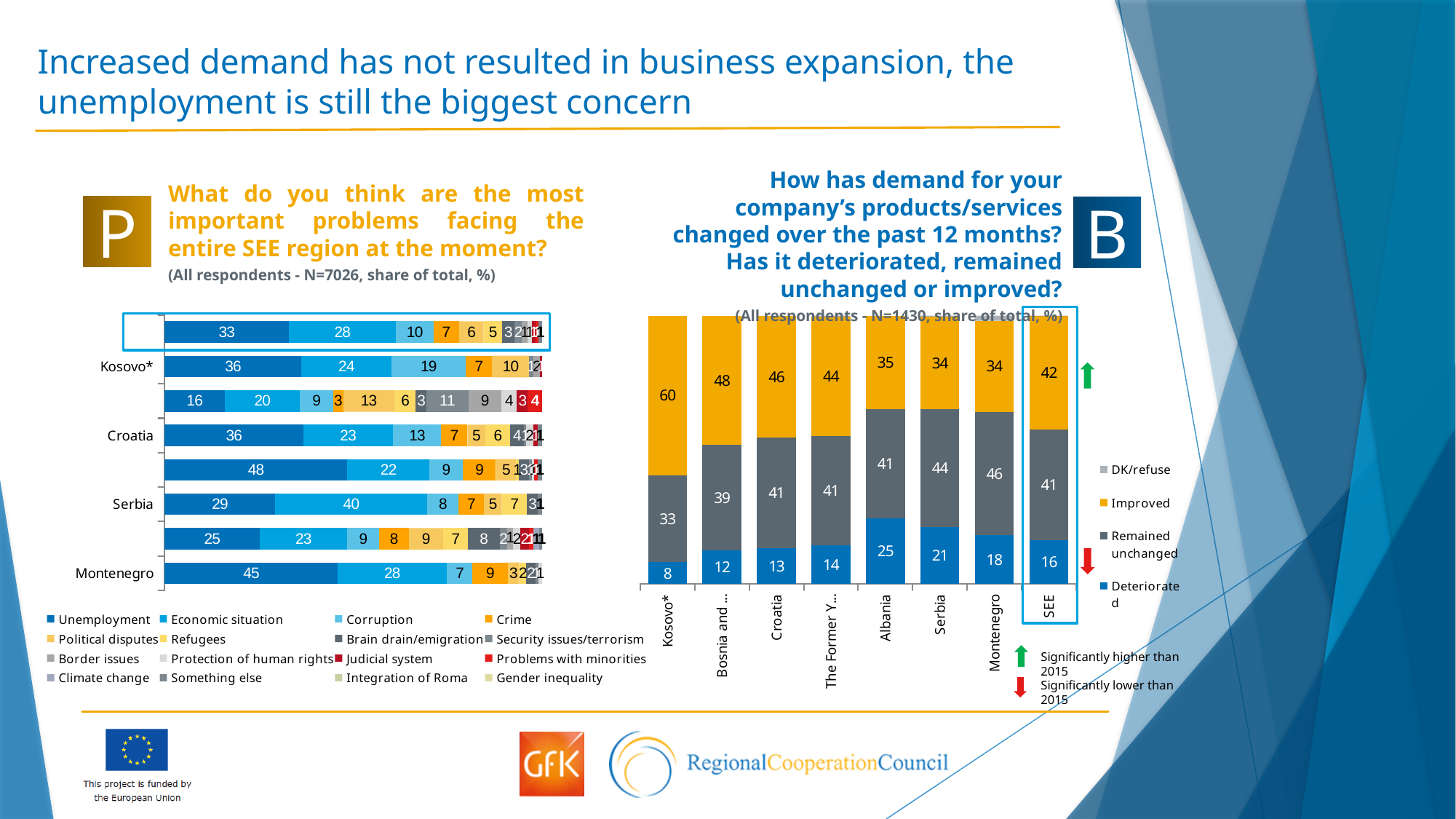
How many series does the legend of the chart 'How has demand for your company's products/services changed over the past 12 months?' list? 4 What kind of chart is the chart 'How has demand for your company's products/services changed over the past 12 months?'? Stacked bar chart In the chart 'How has demand for your company's products/services changed over the past 12 months?', what is the value for Deteriorated for Albania? 25 In the chart 'How has demand for your company's products/services changed over the past 12 months?', what is the total of the stacked bar for Croatia? 100 In the chart 'What do you think are the most important problems facing the entire SEE region at the moment?', what is the Economic situation value for Serbia? 40 In the chart 'How has demand for your company's products/services changed over the past 12 months?', which country has the highest Improved value? Kosovo* In the chart 'How has demand for your company's products/services changed over the past 12 months?', what is the difference between the Improved value for Kosovo* and for SEE? 18 How many countries/regions are shown on the x axis of the chart 'How has demand for your company's products/services changed over the past 12 months?'? 8 In the chart 'How has demand for your company's products/services changed over the past 12 months?', what is the value for Improved for Kosovo*? 60 In the chart 'How has demand for your company's products/services changed over the past 12 months?', which has the larger Remained unchanged value, Serbia or Montenegro? Montenegro In the chart 'What do you think are the most important problems facing the entire SEE region at the moment?', what is the Unemployment value for Montenegro? 45 In the chart 'How has demand for your company's products/services changed over the past 12 months?', which country has the lowest Deteriorated value? Kosovo*